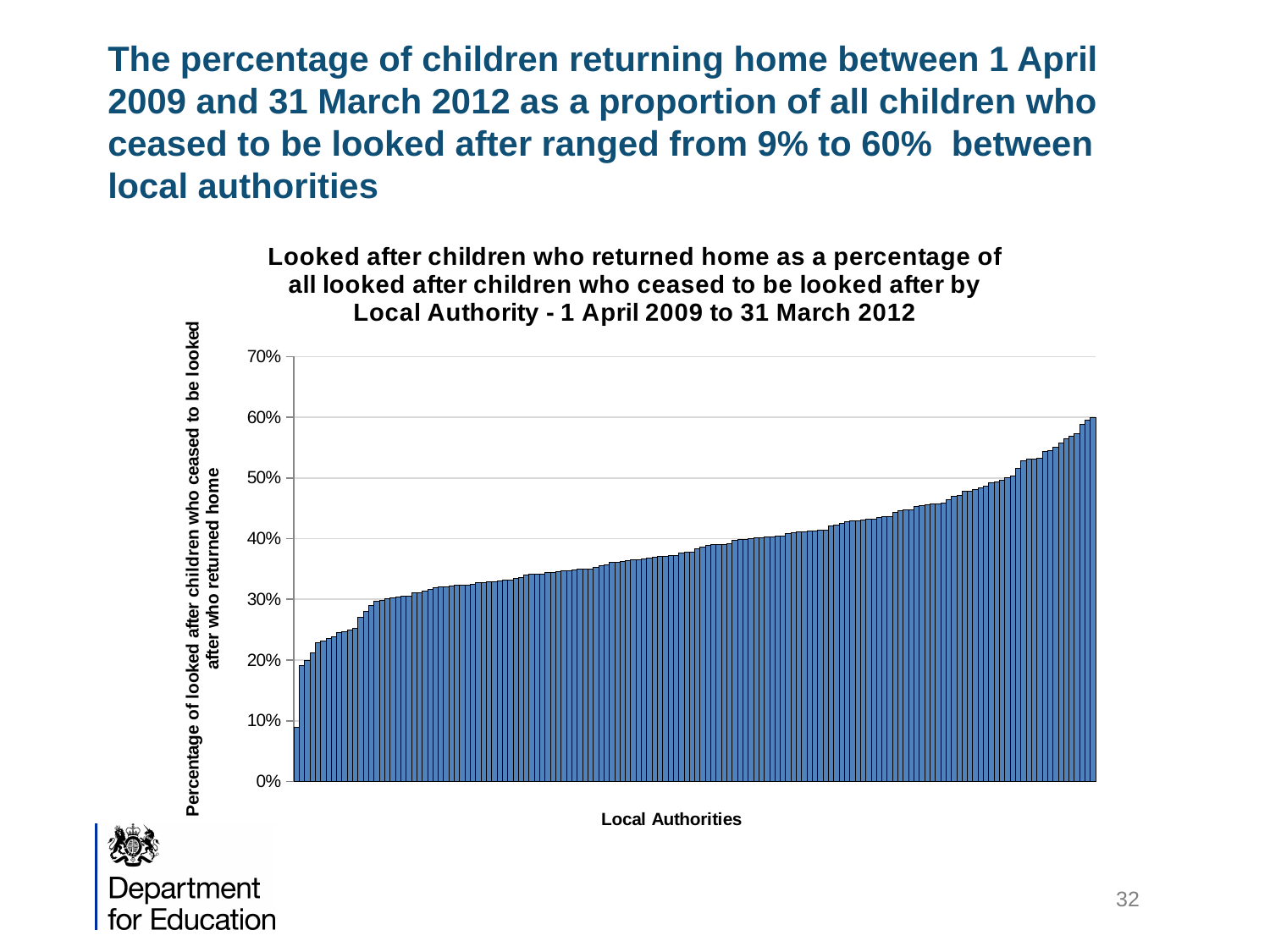
What kind of chart is shown on the slide? bar chart Which bar is taller, the leftmost bar or the rightmost bar? the rightmost bar Is the value of the tallest bar (the rightmost local authority) greater or less than 50%? greater What is the highest value shown on the y axis? 70% What value does the tallest bar reach on the y axis? 60% Is the value of the second bar from the left greater or less than 20%? less Are the bars in the chart vertical or horizontal? vertical What is the label of the x axis? Local Authorities Is the value of the shortest bar (the leftmost local authority) greater or less than 10%? less Do the bar values rise or fall from left to right along the x axis? rise